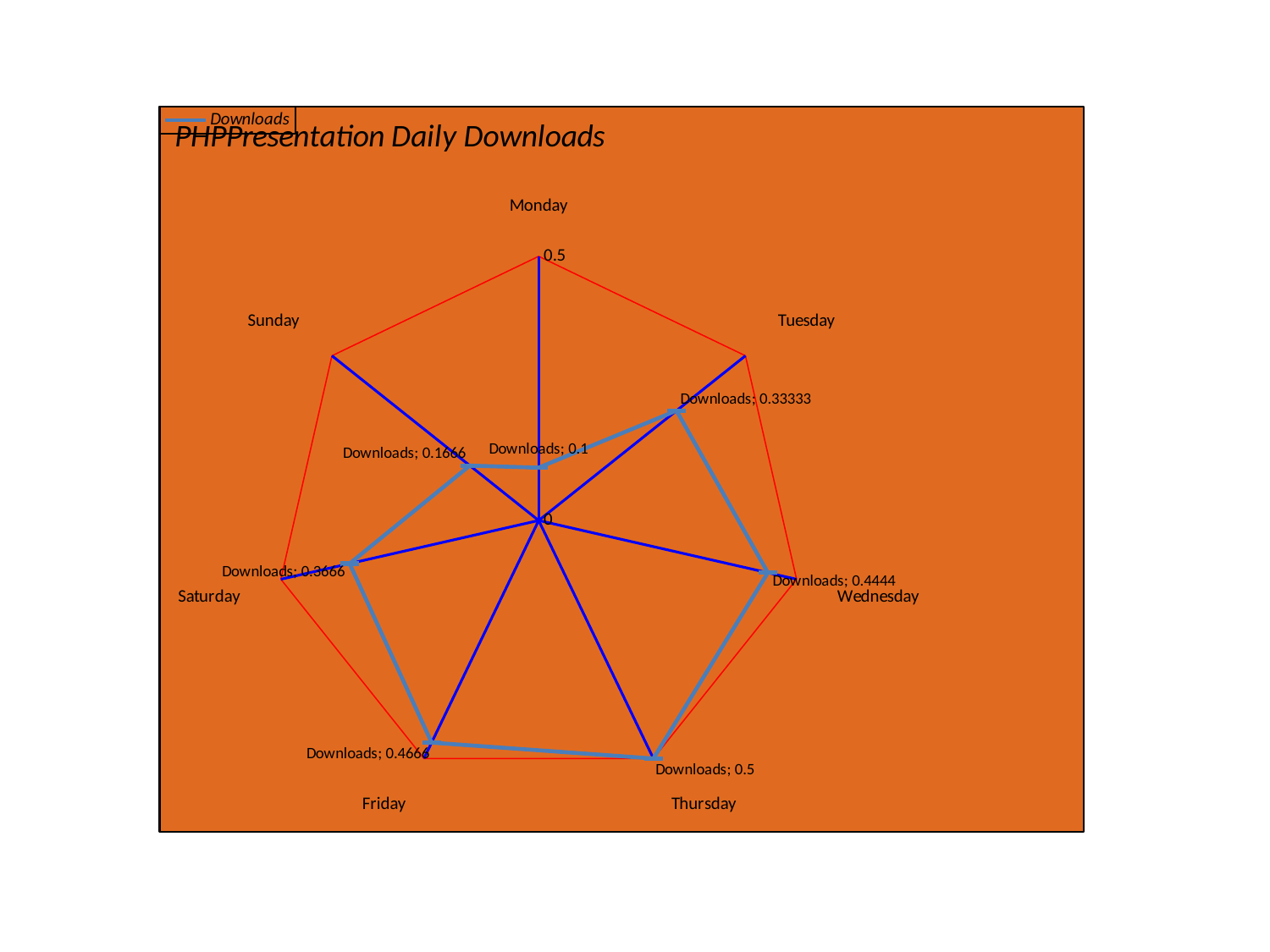
What is the Downloads value for Wednesday? 0.4444 How many series does the legend list? 1 What is the title of the chart? PHPPresentation Daily Downloads What is the difference between the Downloads values for Thursday and Monday? 0.4 Which day has the highest Downloads value? Thursday Is the Downloads value for Friday greater or less than 0.5? less What is the Downloads value for Monday? 0.1 Which day has the lowest Downloads value? Monday How many categories (days) are plotted on the chart? 7 What is the Downloads value for Sunday? 0.1666 What type of chart is shown on the slide? Radar chart What is the Downloads value for Tuesday? 0.33333